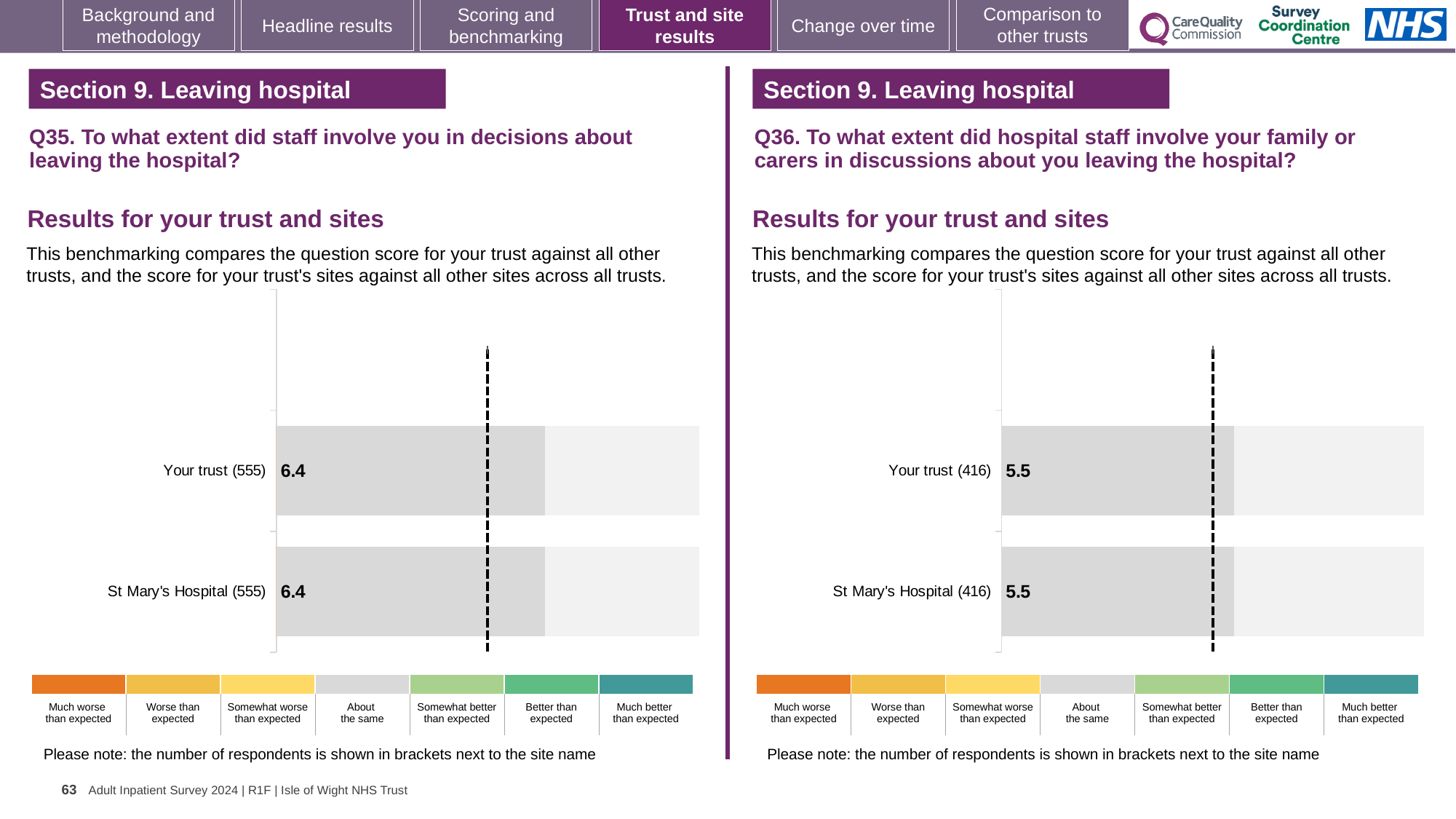
According to the colour key, which benchmark category does the grey colour of the bars in the Q36 chart on the right represent? About the same What kind of chart is used for the Q36 results on the right? Bar chart In the Q35 chart on the left, how many respondents are shown in brackets for Your trust? 555 How many benchmark categories does the colour key below the Q35 chart on the left list? 7 In the Q36 chart on the right, what is the score for St Mary's Hospital? 5.5 What is the difference between the Your trust score in the Q35 chart (left) and the Your trust score in the Q36 chart (right)? 0.9 In the Q36 chart on the right, what is the score for Your trust? 5.5 Is the Your trust score in the Q36 chart on the right greater or less than the Your trust score in the Q35 chart on the left? less How many bars are plotted in the Q35 chart on the left? 2 In the Q35 chart on the left, what is the score for Your trust? 6.4 In the Q35 chart on the left, what is the score for St Mary's Hospital? 6.4 In the Q36 chart on the right, how many respondents are shown in brackets for St Mary's Hospital? 416